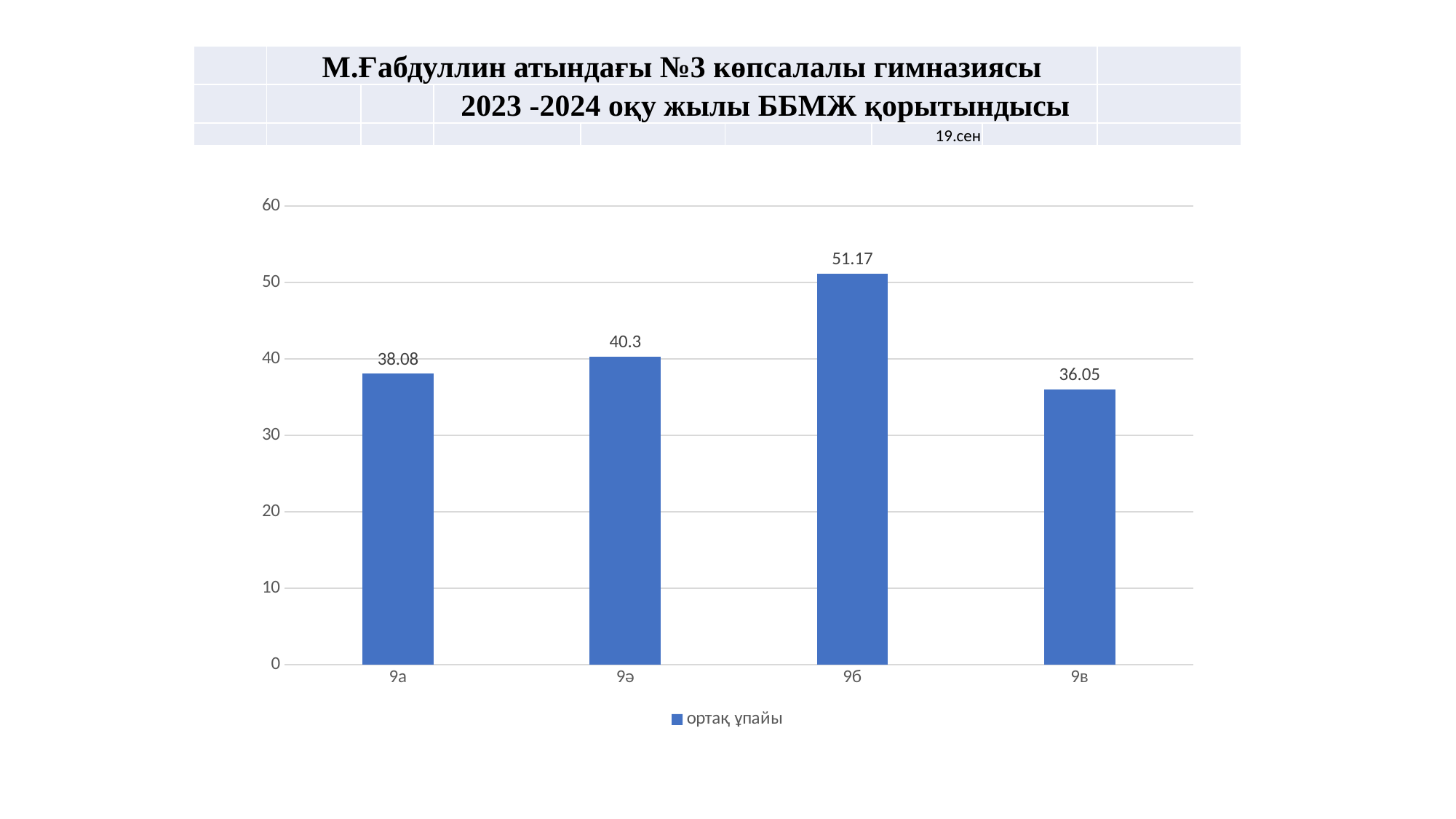
What is the value for 9ә? 40.3 Which category has the highest value? 9б What series name does the legend show? ортақ ұпайы Which category has the lowest value? 9в What is the value for 9в? 36.05 What is the difference between the values for 9б and 9а? 13.09 What kind of chart is shown on the slide? bar chart What is the value for 9б? 51.17 Is the value for 9б greater or less than 50? greater How many categories are shown on the x axis? 4 What is the value for 9а? 38.08 Which is larger, the value for 9ә or the value for 9в? 9ә